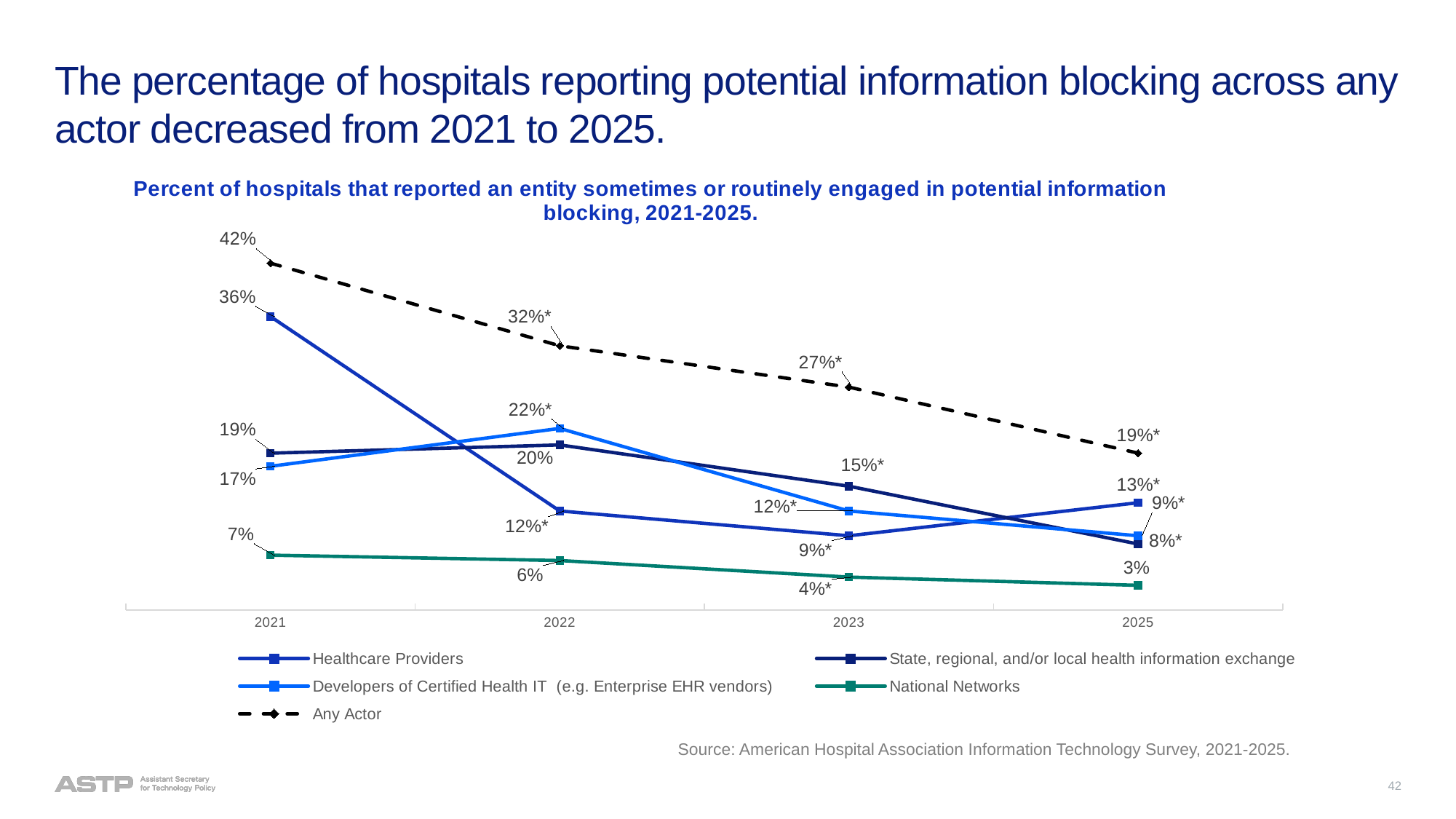
In 2021, which was higher: Healthcare Providers or State, regional, and/or local health information exchange? Healthcare Providers What percentage of hospitals reported potential information blocking by Any Actor in 2021? 42% How many series does the legend list? 5 What is the Any Actor value for 2025? 19%* What is the value for Developers of Certified Health IT in 2022? 22%* What is the value for National Networks in 2021? 7% Which series had the lowest value in 2021? National Networks Does the Any Actor line rise or fall from 2021 to 2025? Fall How many years are shown on the x axis? 4 What kind of chart is shown on the slide? Line chart What percentage is shown for Healthcare Providers in 2021? 36% By how many percentage points did the Any Actor value decrease from 2021 (42%) to 2025 (19%)? 23 percentage points